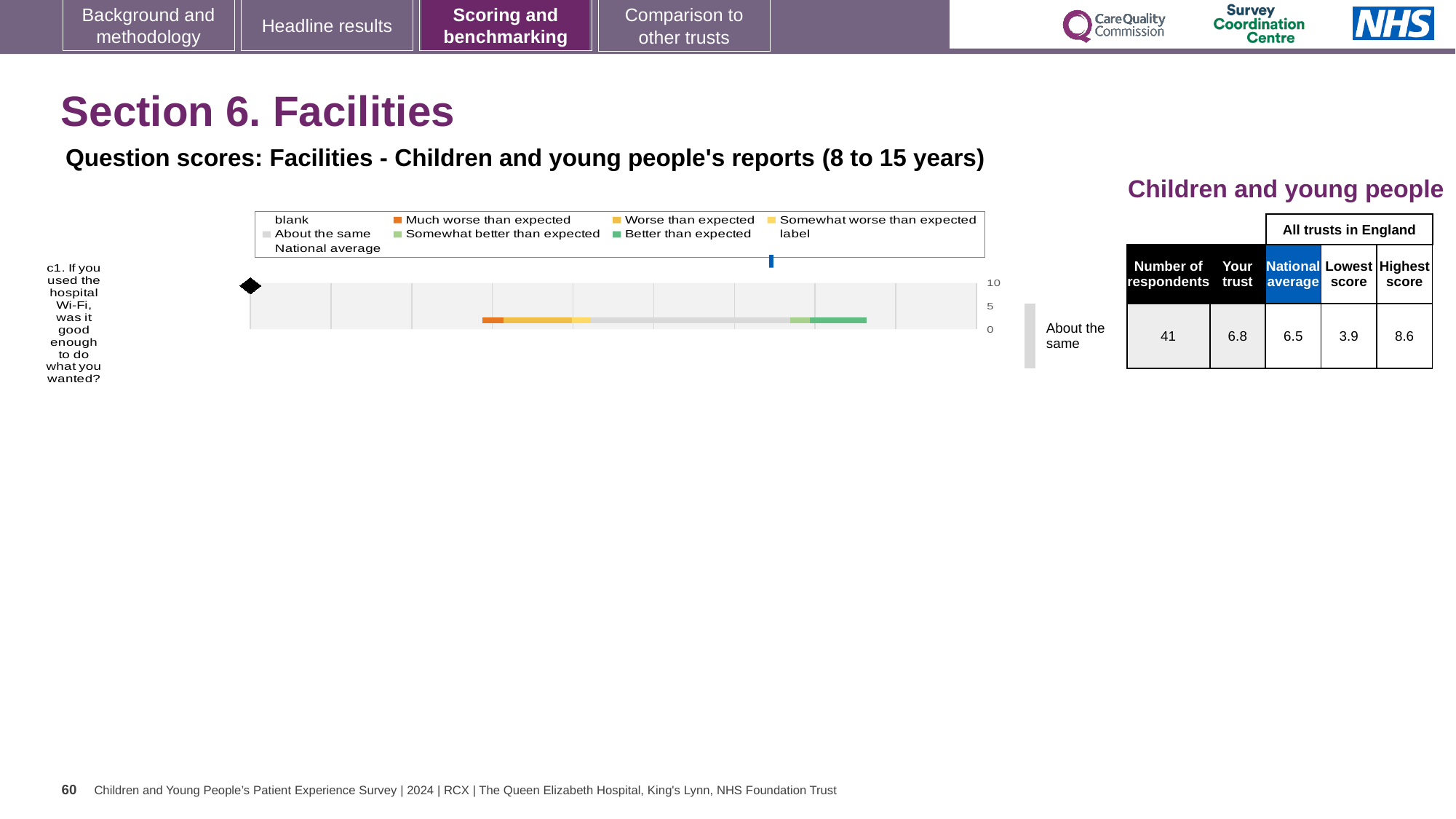
Which benchmarking category is the trust's result for question c1 placed in? About the same What is the difference between the highest score and the lowest score for question c1? 4.7 What is the lowest score among all trusts in England for question c1? 3.9 How many survey questions are plotted in the chart? 1 What is the national average score for question c1 about the hospital Wi-Fi? 6.5 Which is larger for question c1, the 'Your trust' score or the national average? Your trust What is the 'Your trust' score for question c1 about the hospital Wi-Fi? 6.8 How many respondents answered question c1 about the hospital Wi-Fi? 41 What kind of chart is shown on the slide? bar chart How many entries does the chart legend list? 9 What is the highest score among all trusts in England for question c1? 8.6 What is the difference between the 'Your trust' score and the national average for question c1? 0.3